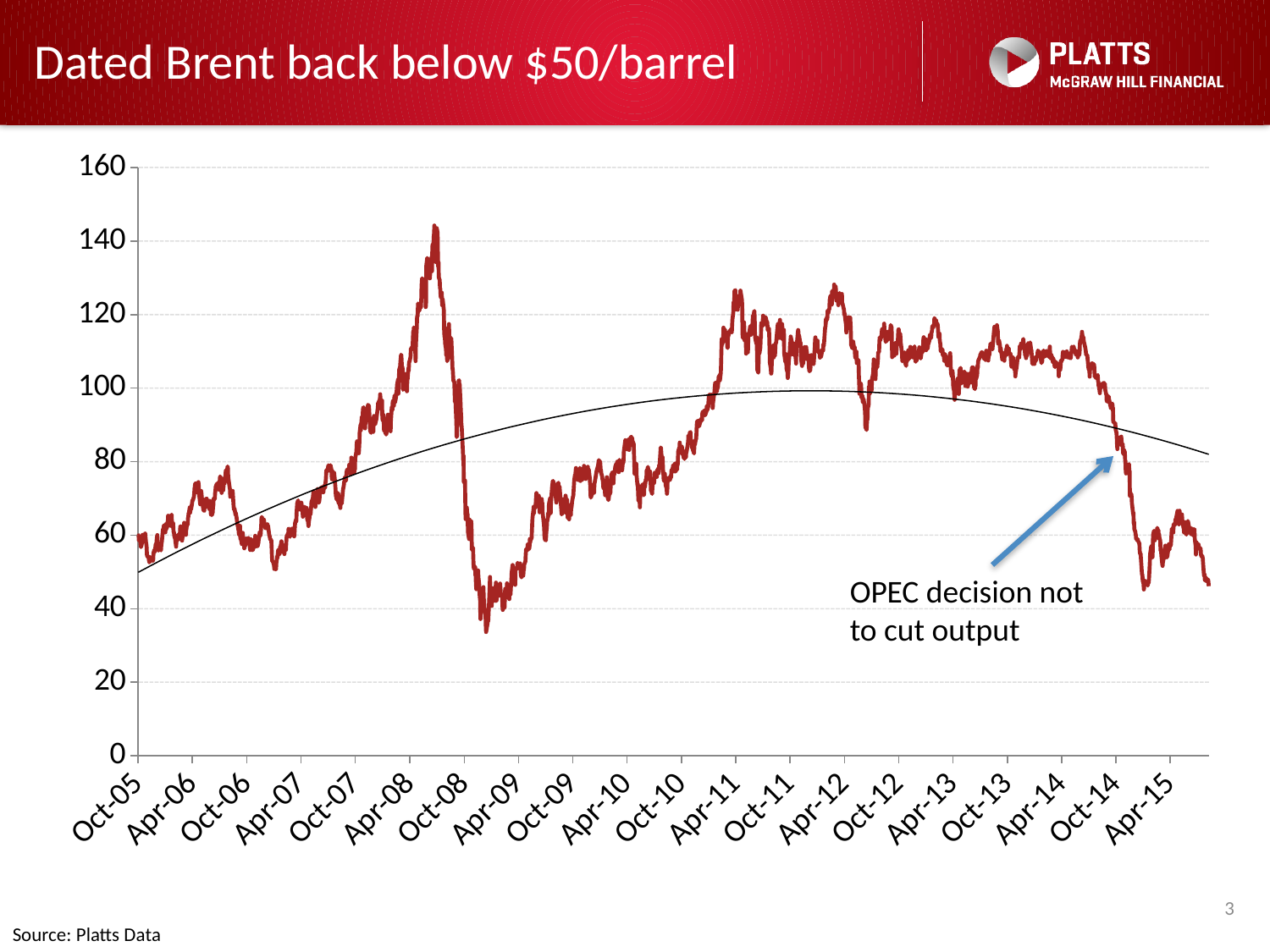
What is the title of the slide containing the chart? Dated Brent back below $50/barrel Is the lowest point of the red line, reached around the start of 2009, greater or less than 40? less Is the highest point of the red line, reached in mid-2008, greater or less than 120? greater Does the red line rise or fall between Oct-14 and Apr-15? fall Which is higher on the red line: the value at Apr-12 or the value at Apr-09? Apr-12 Does the red line rise or fall between Apr-09 and Apr-11? rise What event does the annotation with the arrow on the chart refer to? OPEC decision not to cut output How many date labels are shown on the x axis? 20 Is the value of the red line at Oct-05 greater or less than 80? less What kind of chart is shown on the slide? line chart